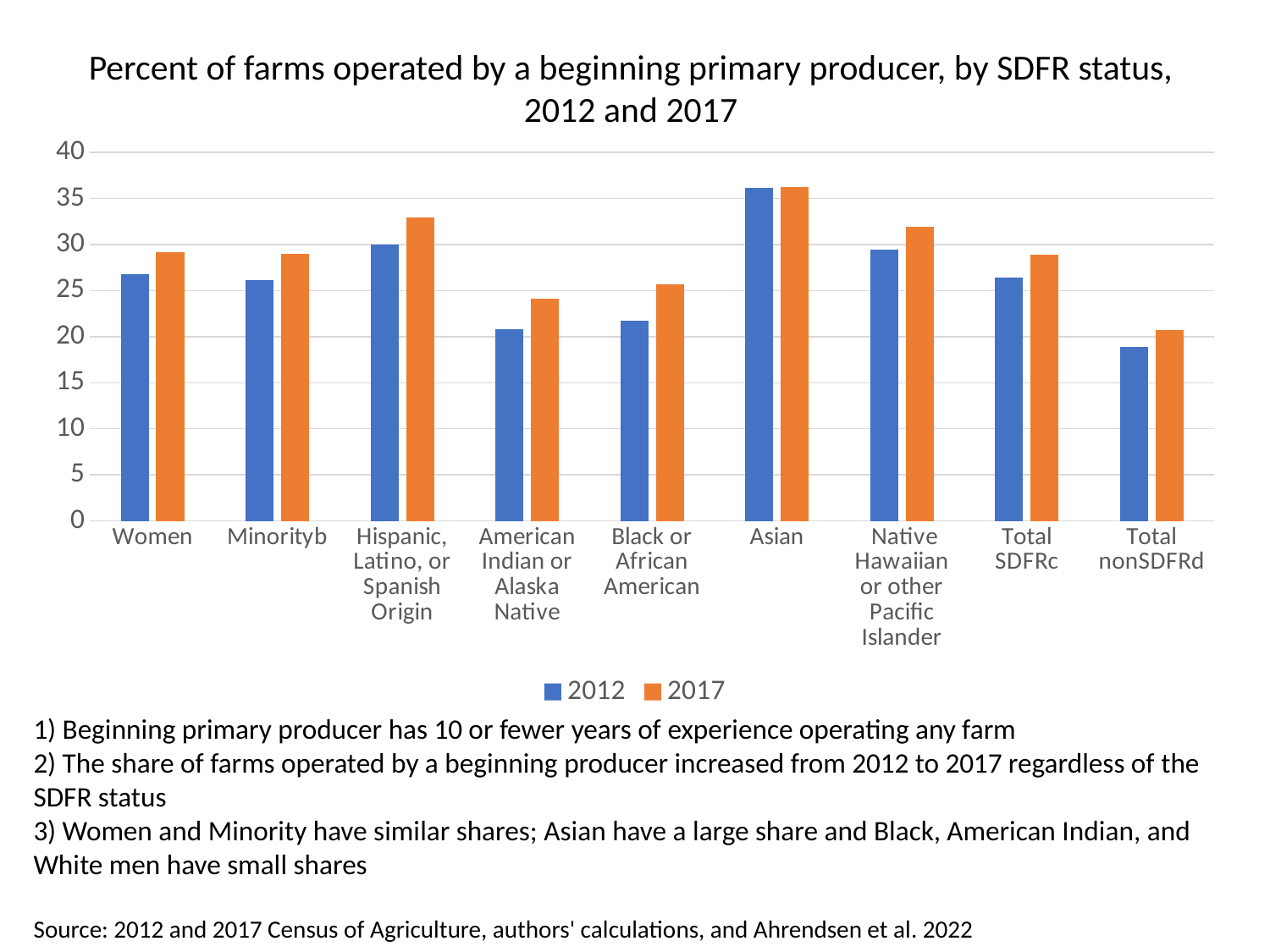
Is the value for Asian in 2017 greater or less than 35? greater Is the value for Women in 2012 greater or less than 25? greater Which category has the highest value for 2017? Asian Is the value for Total nonSDFRd in 2012 greater or less than 20? less What kind of chart is shown on the slide? bar chart How many categories are shown on the x axis? 9 Which is larger: the 2012 value for Asian or the 2012 value for Women? Asian Which colour represents the 2017 series in the chart? orange How many series does the legend list? 2 Which category has the lowest value for 2012? Total nonSDFRd For each category, is the 2017 bar higher or lower than the 2012 bar? higher